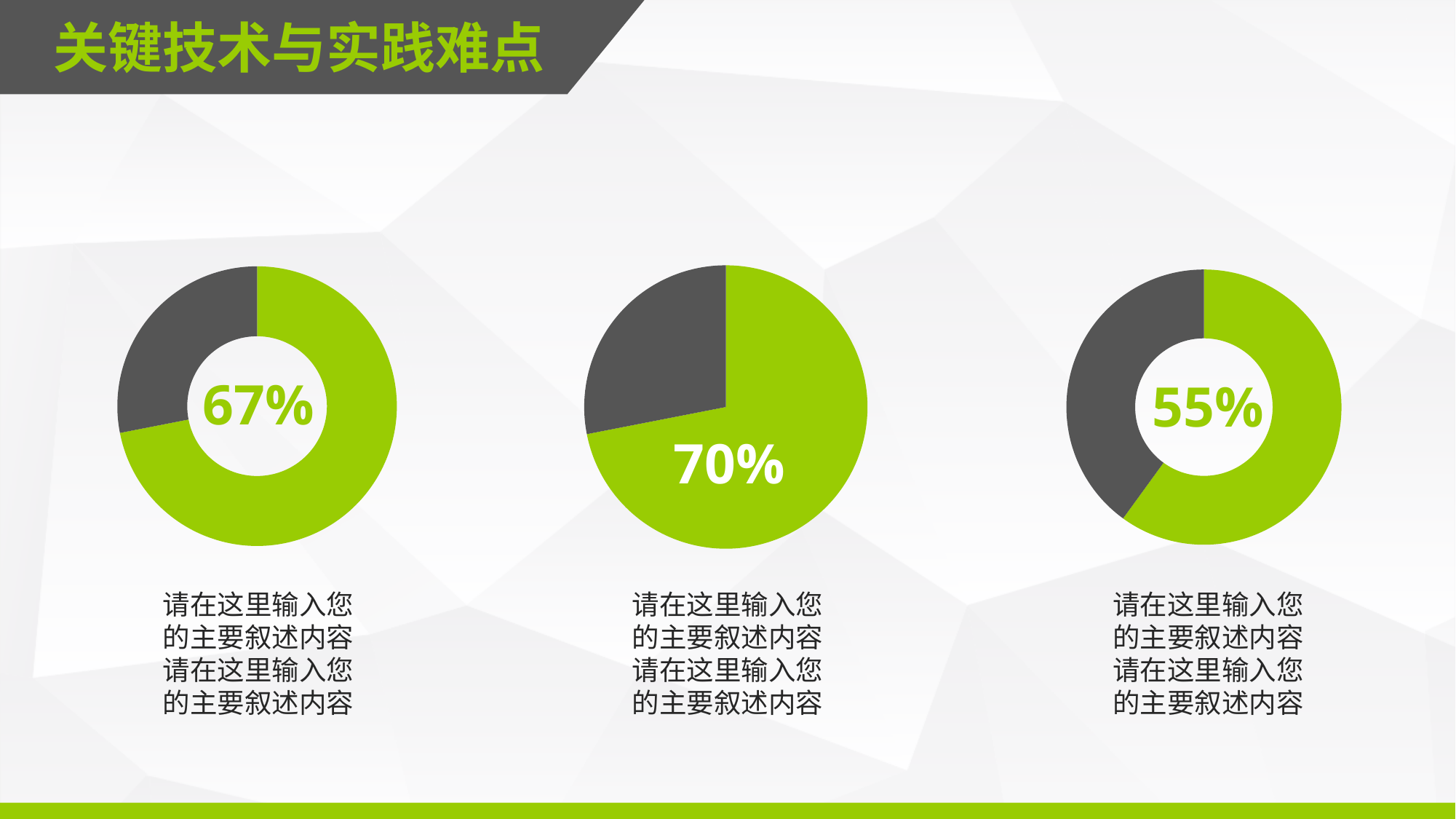
What kind of chart is the left chart on the slide? doughnut chart What percentage is shown in the centre of the left doughnut chart? 67% What percentage is shown in the centre of the right doughnut chart? 55% What is the difference between the percentage on the middle chart and the percentage on the right chart? 15% What kind of chart is the middle chart on the slide? pie chart Which of the three charts shows the highest percentage? the middle chart (70%) How many slices does the left doughnut chart have? 2 Which of the three charts shows the lowest percentage? the right chart (55%) What percentage is printed on the middle pie chart? 70% Is the percentage on the left chart larger or smaller than the percentage on the right chart? larger What colour is the larger slice in each of the three charts? green